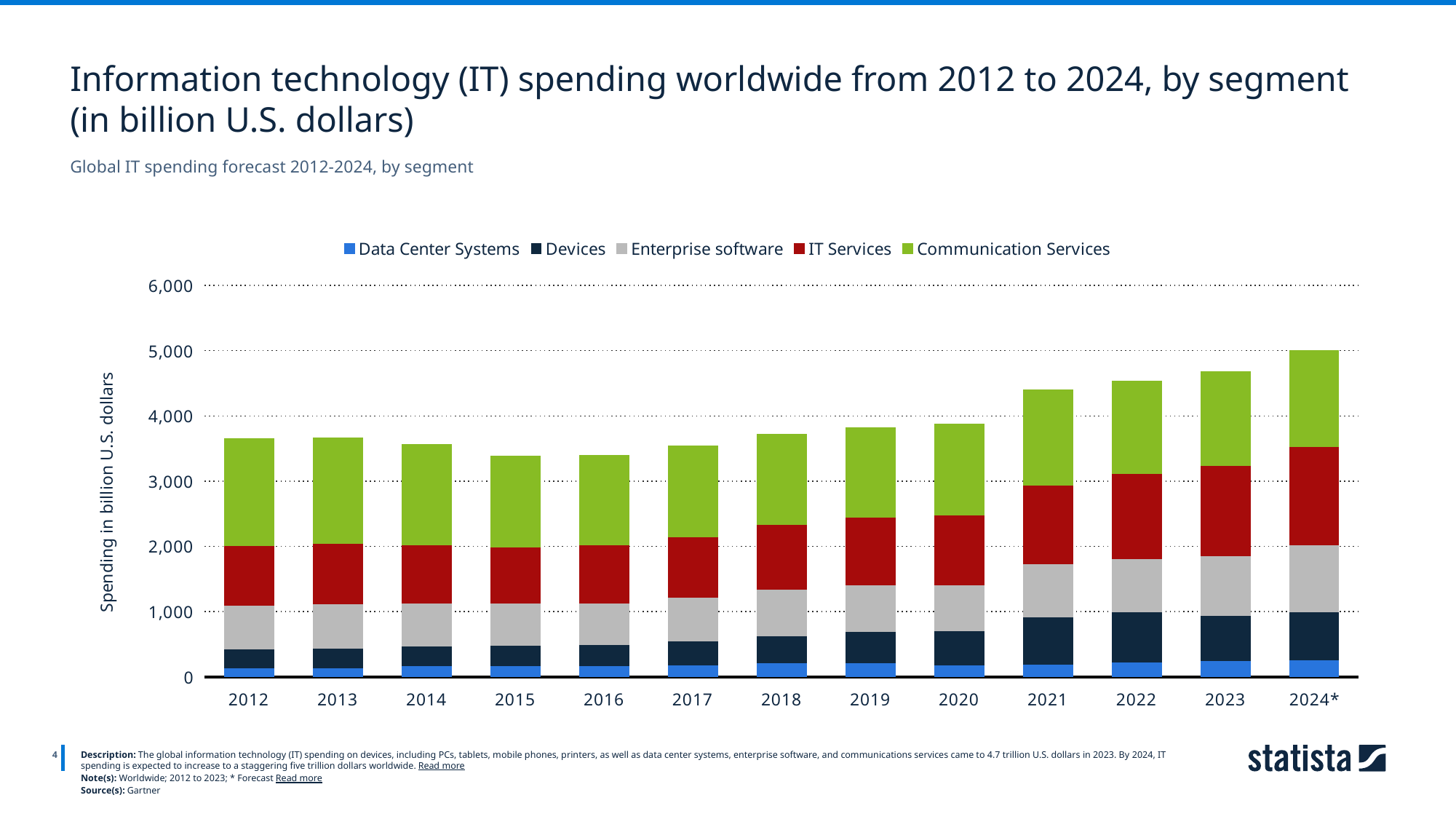
Do total IT spending values rise or fall from 2020 to 2024*? rise How many years are shown on the x axis? 13 What is the label on the y axis? Spending in billion U.S. dollars Is the total IT spending for 2021 greater or less than 4,000? greater Which year has the highest total IT spending? 2024* Is the total IT spending for 2012 greater or less than 5,000? less Is the total IT spending for 2024* greater or less than 4,000? greater How many series does the legend list? 5 Which series is shown in green in the legend? Communication Services What kind of chart is shown on the slide? Stacked bar chart Which year has the larger total IT spending, 2018 or 2021? 2021